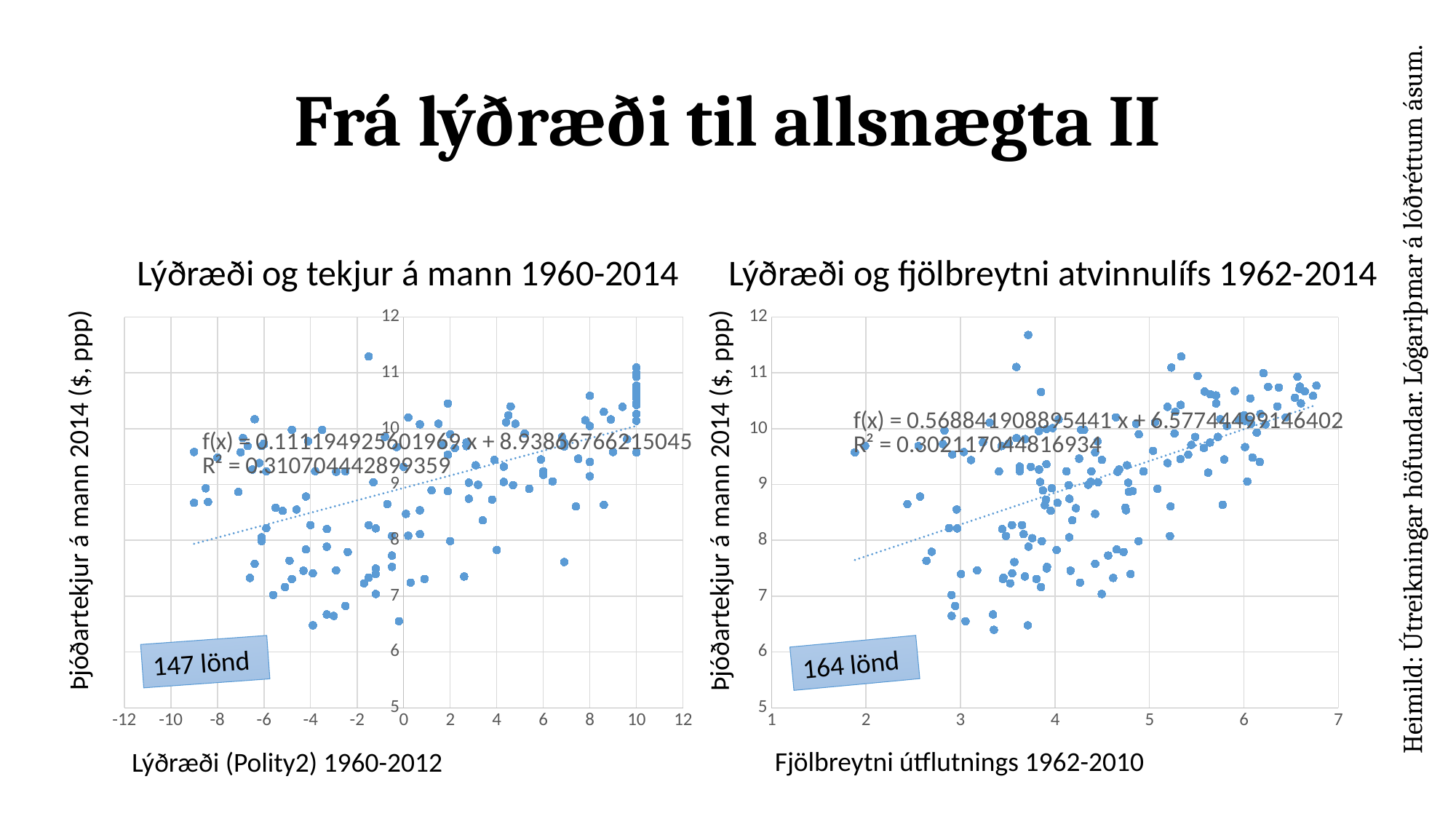
What kind of chart is the right chart, 'Lýðræði og fjölbreytni atvinnulífs 1962-2014'? Scatter chart In the left chart, 'Lýðræði og tekjur á mann 1960-2014', does the trendline rise or fall as the x-axis value increases? Rise What is the x-axis label of the right chart, 'Lýðræði og fjölbreytni atvinnulífs 1962-2014'? Fjölbreytni útflutnings 1962-2010 In the right chart, 'Lýðræði og fjölbreytni atvinnulífs 1962-2014', does the trendline rise or fall as the x-axis value increases? Rise In the left chart, 'Lýðræði og tekjur á mann 1960-2014', what is the trendline equation shown? f(x) = 0.111194925601969 x + 8.93866766215045 In the right chart, 'Lýðræði og fjölbreytni atvinnulífs 1962-2014', what is the trendline equation shown? f(x) = 0.568841908895441 x + 6.57744499146402 Which chart has the higher R² value, the left chart 'Lýðræði og tekjur á mann 1960-2014' or the right chart 'Lýðræði og fjölbreytni atvinnulífs 1962-2014'? Lýðræði og tekjur á mann 1960-2014 In the left chart, 'Lýðræði og tekjur á mann 1960-2014', what is the R² value shown for the trendline? 0.310704442899359 In the left chart, 'Lýðræði og tekjur á mann 1960-2014', how many countries (lönd) does the label say are plotted? 147 lönd What kind of chart is the left chart, 'Lýðræði og tekjur á mann 1960-2014'? Scatter chart In the right chart, 'Lýðræði og fjölbreytni atvinnulífs 1962-2014', what is the R² value shown for the trendline? 0.302117044816934 In the right chart, 'Lýðræði og fjölbreytni atvinnulífs 1962-2014', how many countries (lönd) does the label say are plotted? 164 lönd